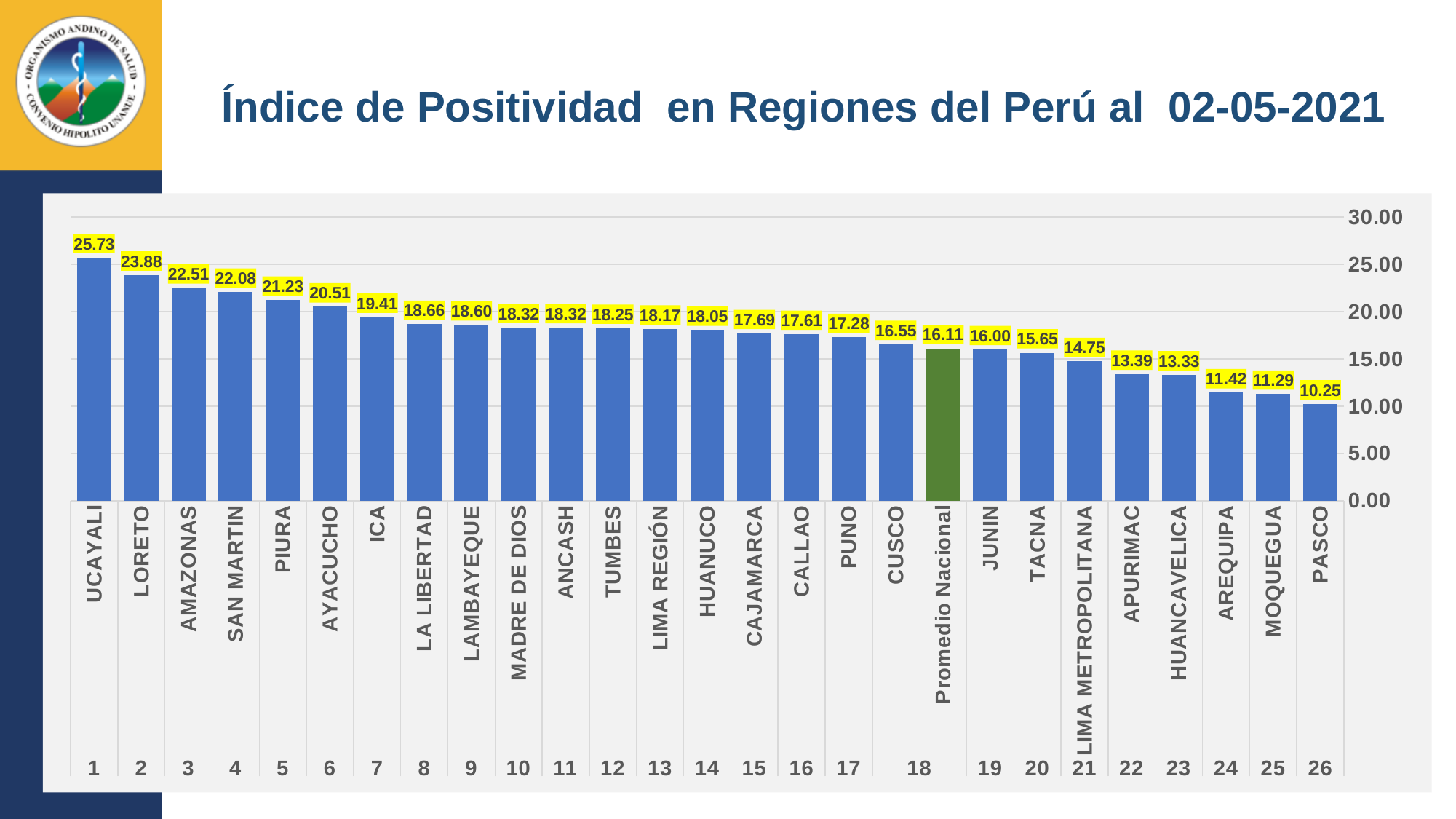
What type of chart is shown on the slide? bar chart Which region has the lowest positivity index? PASCO How many bars are plotted in the chart, including Promedio Nacional? 27 Which has a higher value, PIURA or AYACUCHO? PIURA What is the difference between the values for LORETO and AMAZONAS? 1.37 Which region has the highest positivity index? UCAYALI Which bar is coloured green instead of blue? Promedio Nacional Is the value for CUSCO greater or less than 20.00? less What is the value shown for Promedio Nacional? 16.11 What is the difference between the values for UCAYALI and PASCO? 15.48 What is the positivity index value for UCAYALI? 25.73 What is the value shown for LIMA METROPOLITANA? 14.75